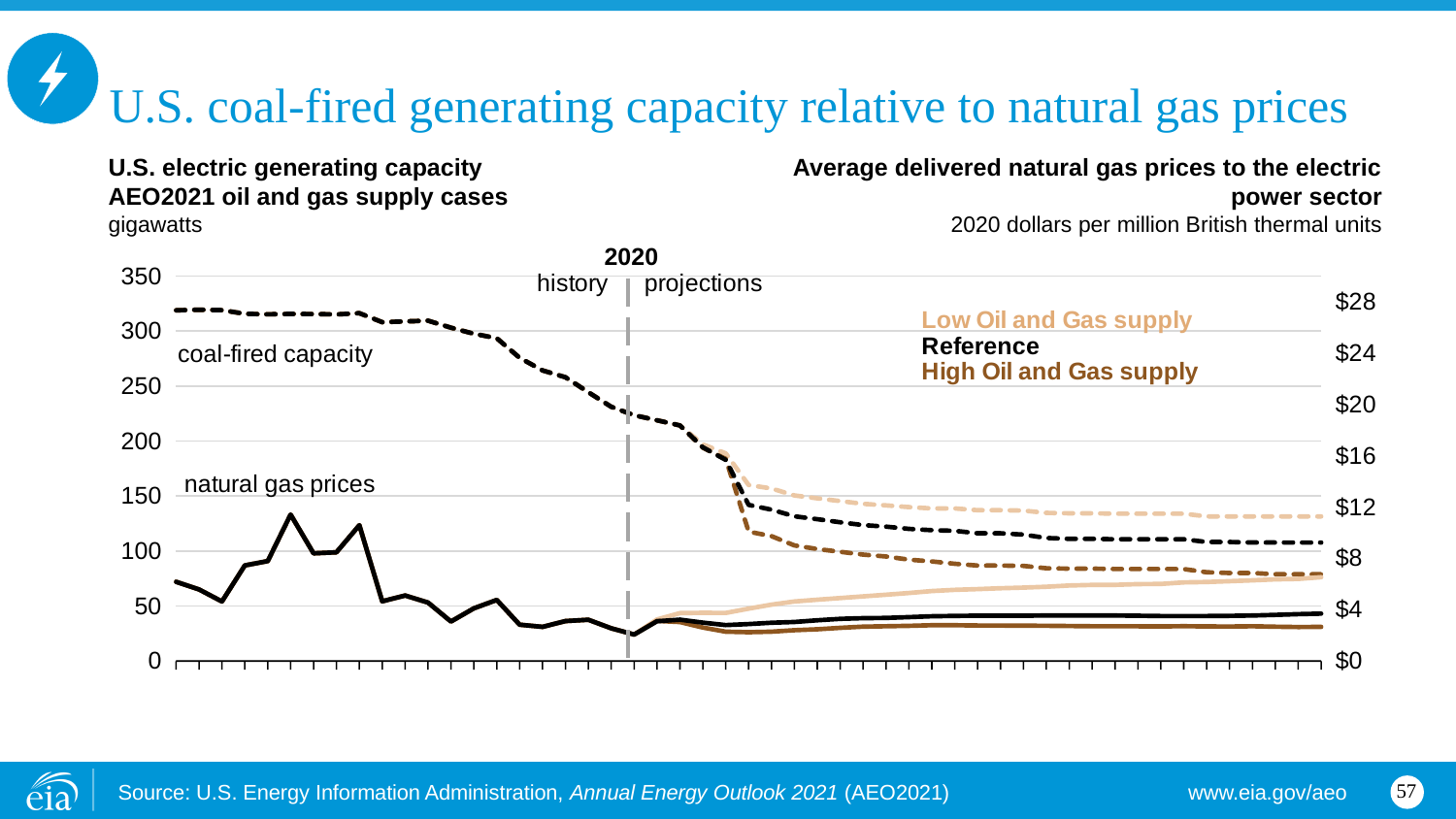
Which case has the highest coal-fired capacity at the end of the projection period? Low Oil and Gas supply Is the natural gas price in the High Oil and Gas supply case at the end of the projection period greater or less than $4? less At the end of the projection period, which case has higher coal-fired capacity: Low Oil and Gas supply or High Oil and Gas supply? Low Oil and Gas supply How many oil and gas supply cases does the legend list? 3 Does coal-fired capacity rise or fall over the history period? fall Which year does the dashed vertical line separating history from projections mark? 2020 What unit is used on the left axis for coal-fired capacity? gigawatts Is coal-fired capacity in the Reference case at the end of the projection period greater or less than 150 gigawatts? less Is coal-fired capacity at the start of the history period greater or less than 300 gigawatts? greater What kind of chart is shown on the slide? line chart